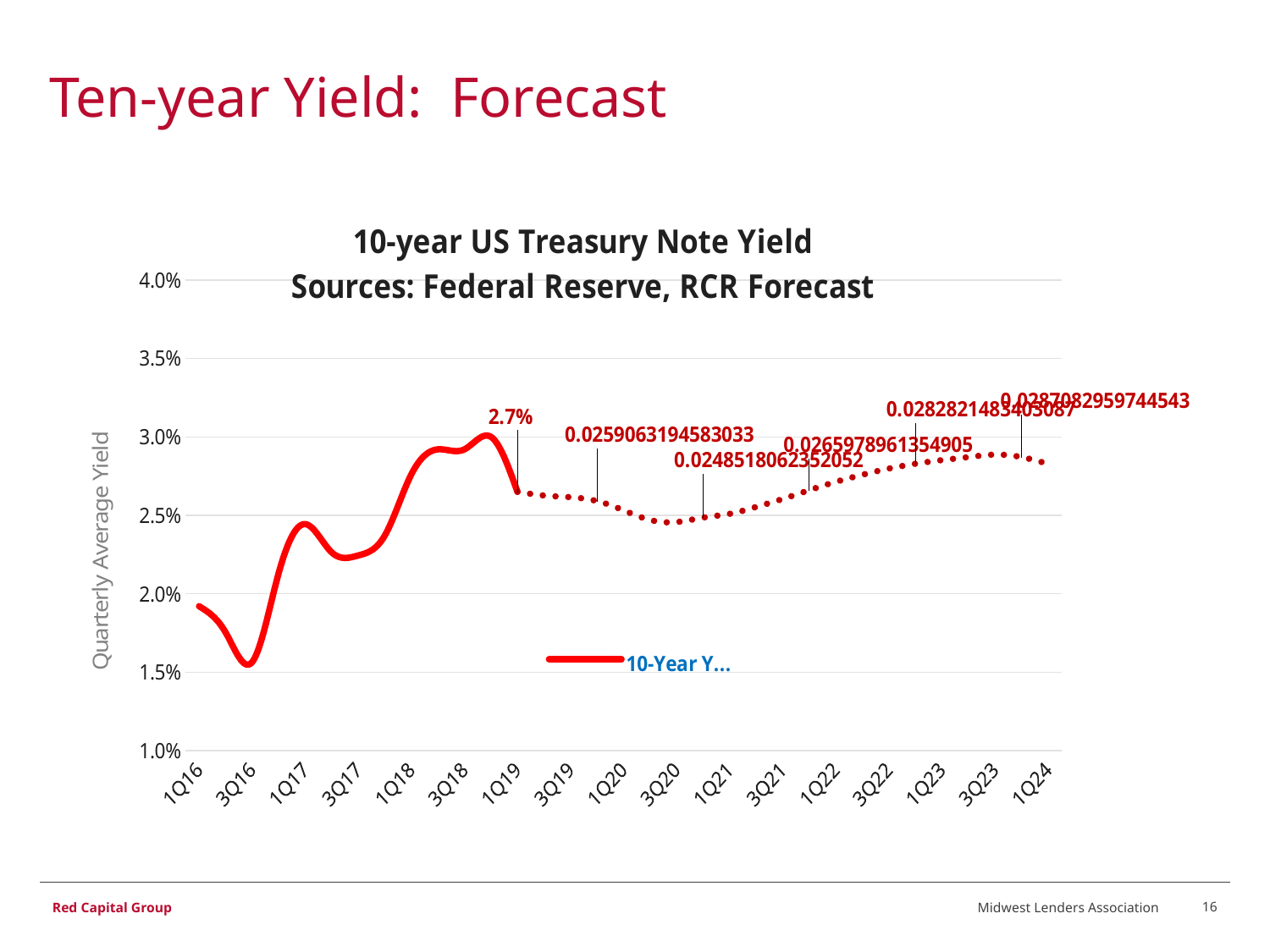
Is the value for 3Q16 greater or less than 2.0%? less What is the title of the vertical axis? Quarterly Average Yield What is the data label shown for 1Q19? 2.7% What is the data label shown for 3Q21? 0.0265978961354905 Which quarter on the x axis has the lowest yield? 3Q16 How many quarter labels are shown on the x axis? 17 Does the yield rise or fall between 1Q19 and 3Q20? fall Is the value for 1Q18 greater or less than 2.5%? greater What is the data label shown for 1Q21? 0.0248518062352052 What is the data label shown for 3Q19? 0.0259063194583033 What kind of chart is shown on the slide? line chart Which is larger, the labelled value for 3Q19 or the labelled value for 1Q21? 3Q19